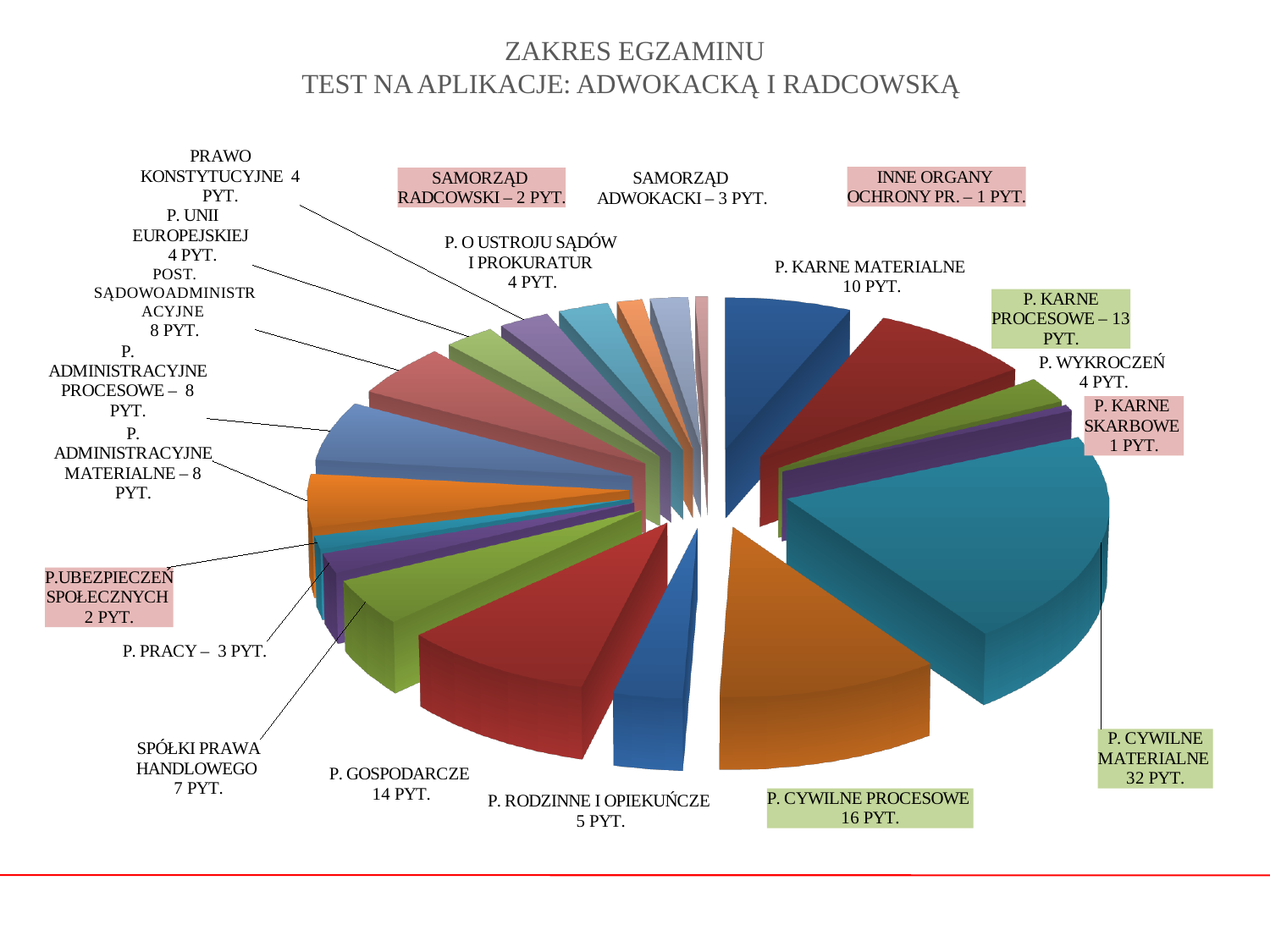
How many questions are allocated to P. KARNE PROCESOWE? 13 PYT. What is the difference in the number of questions between P. CYWILNE MATERIALNE and P. CYWILNE PROCESOWE? 16 How many questions are allocated to SAMORZĄD ADWOKACKI? 3 PYT. Which category has the largest number of questions? P. CYWILNE MATERIALNE How many questions (PYT.) are allocated to P. CYWILNE MATERIALNE? 32 PYT. What is the difference in the number of questions between P. KARNE PROCESOWE and P. KARNE MATERIALNE? 3 How many questions are allocated to P. GOSPODARCZE? 14 PYT. How many questions are allocated to SPÓŁKI PRAWA HANDLOWEGO? 7 PYT. What kind of chart is shown on the slide? pie chart What is the title shown at the top of the slide? ZAKRES EGZAMINU TEST NA APLIKACJE: ADWOKACKĄ I RADCOWSKĄ Which has more questions, P. GOSPODARCZE or P. RODZINNE I OPIEKUŃCZE? P. GOSPODARCZE How many categories are shown in the pie chart? 20